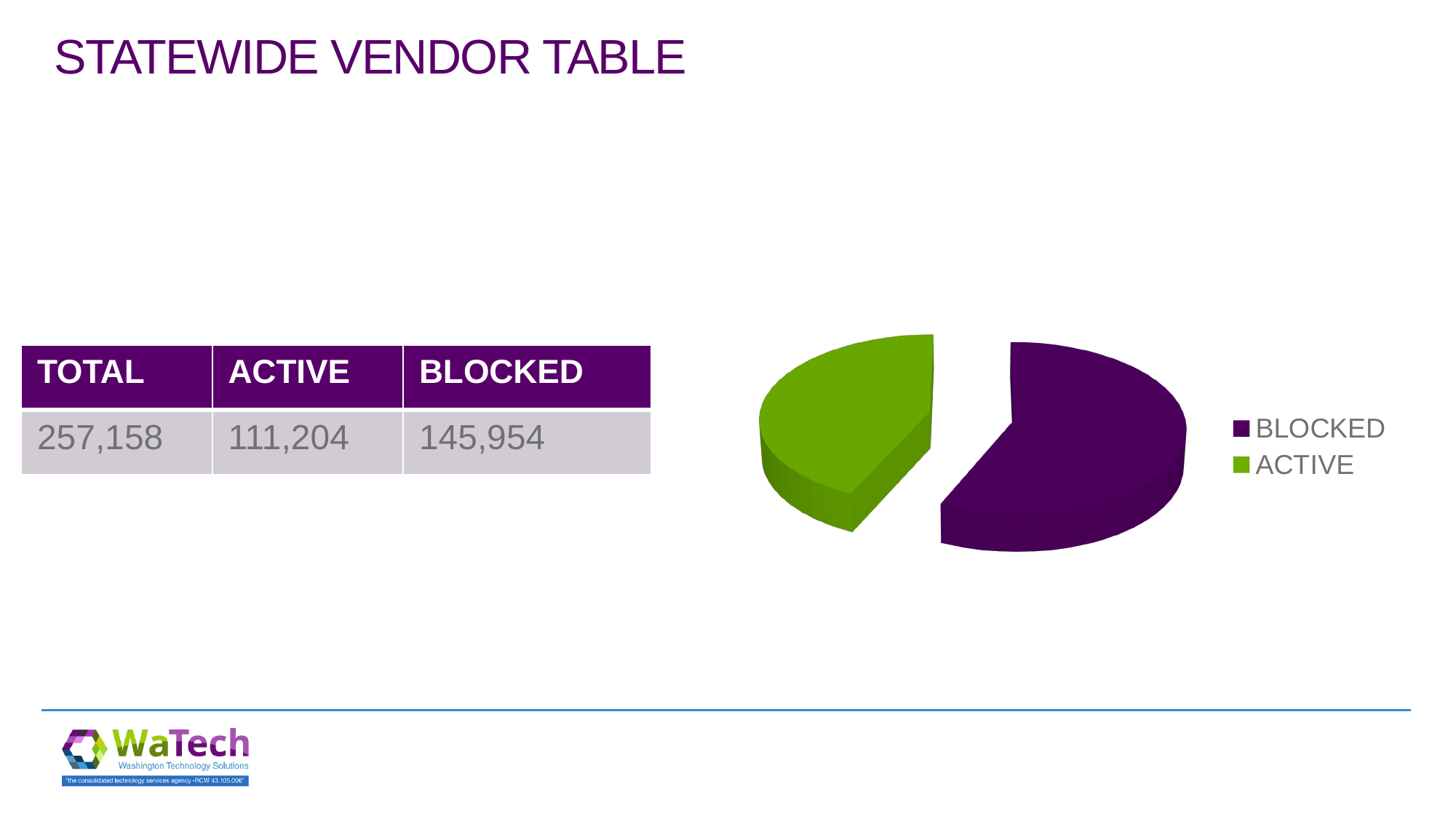
According to the table on the slide, what is the value for BLOCKED vendors? 145,954 Which category has the largest slice in the pie chart? BLOCKED Which category has the smallest slice in the pie chart? ACTIVE How many entries does the pie chart's legend list? 2 What kind of chart is shown on the slide? pie chart What colour is the ACTIVE slice in the pie chart? green What is the difference between the BLOCKED and ACTIVE vendor counts shown in the table? 34,750 What colour is the BLOCKED slice in the pie chart? purple Which slice of the pie chart is larger, BLOCKED or ACTIVE? BLOCKED How many slices does the pie chart have? 2 According to the table on the slide, what is the value for ACTIVE vendors? 111,204 What is the TOTAL number of vendors shown in the table? 257,158